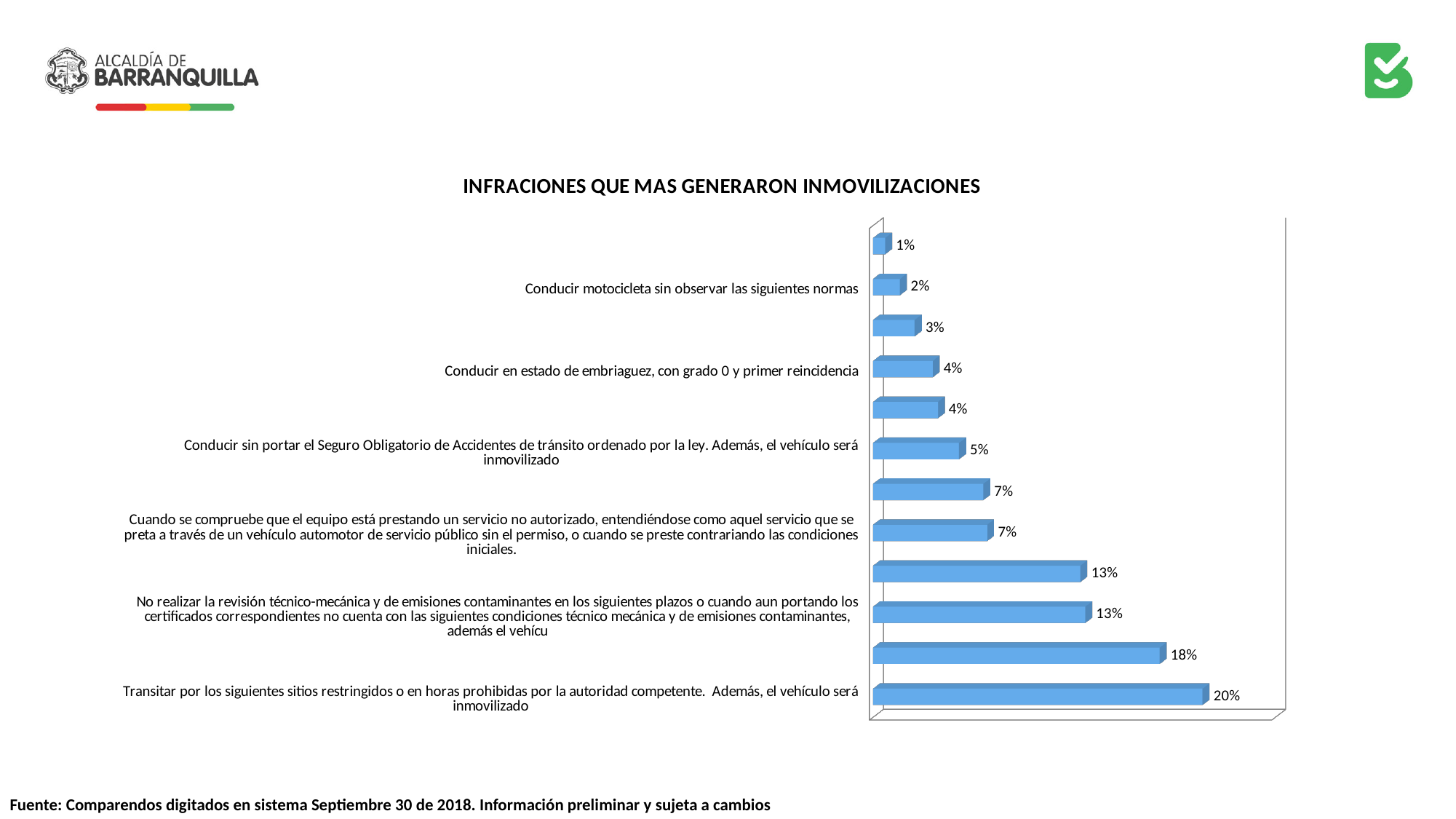
What is the title of the chart? INFRACIONES QUE MAS GENERARON INMOVILIZACIONES What is the value for 'Cuando se compruebe que el equipo está prestando un servicio no autorizado'? 7% What is the difference between the value for 'Transitar por los siguientes sitios restringidos' and the value for 'No realizar la revisión técnico-mecánica'? 7 percentage points How many bars are plotted in the chart? 12 What is the value for 'Conducir motocicleta sin observar las siguientes normas'? 2% What type of chart is shown on the slide? Bar chart What is the value for 'Transitar por los siguientes sitios restringidos o en horas prohibidas por la autoridad competente'? 20% Which is larger: the value for 'Conducir sin portar el Seguro Obligatorio' or the value for 'Conducir motocicleta sin observar las siguientes normas'? Conducir sin portar el Seguro Obligatorio What is the value for 'No realizar la revisión técnico-mecánica y de emisiones contaminantes'? 13% What is the value for 'Conducir sin portar el Seguro Obligatorio de Accidentes de tránsito'? 5% Which category has the highest value in the chart? Transitar por los siguientes sitios restringidos o en horas prohibidas por la autoridad competente What is the value for 'Conducir en estado de embriaguez, con grado 0 y primer reincidencia'? 4%